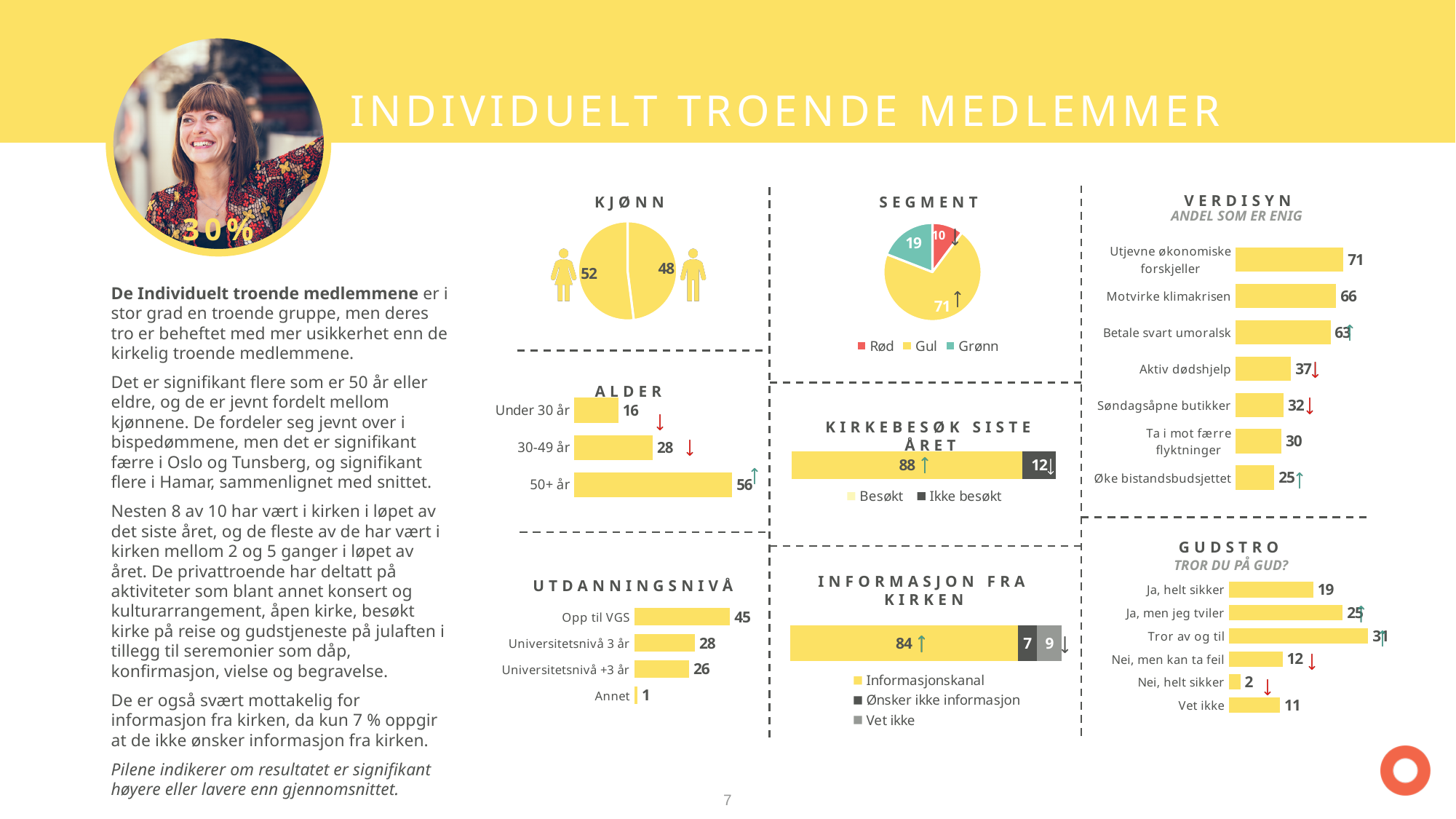
In the VERDISYN chart, which statement has the highest share agreeing? Utjevne økonomiske forskjeller In the UTDANNINGSNIVÅ chart, what is the difference between Opp til VGS and Universitetsnivå 3 år? 17 In the SEGMENT pie chart, which segment is the largest? Gul In the SEGMENT pie chart, what is the value for Grønn? 19 In the VERDISYN chart, what is the value for Motvirke klimakrisen? 66 How many categories are shown in the UTDANNINGSNIVÅ chart? 4 In the ALDER chart, which age group has the lowest value? Under 30 år In the ALDER chart, what is the value for 50+ år? 56 How many series does the legend of the SEGMENT chart list? 3 In the KIRKEBESØK SISTE ÅRET chart, what is the total of the stacked bar? 100 What type of chart is the KJØNN chart? Pie chart In the GUDSTRO chart, which is larger: Ja, helt sikker or Tror av og til? Tror av og til